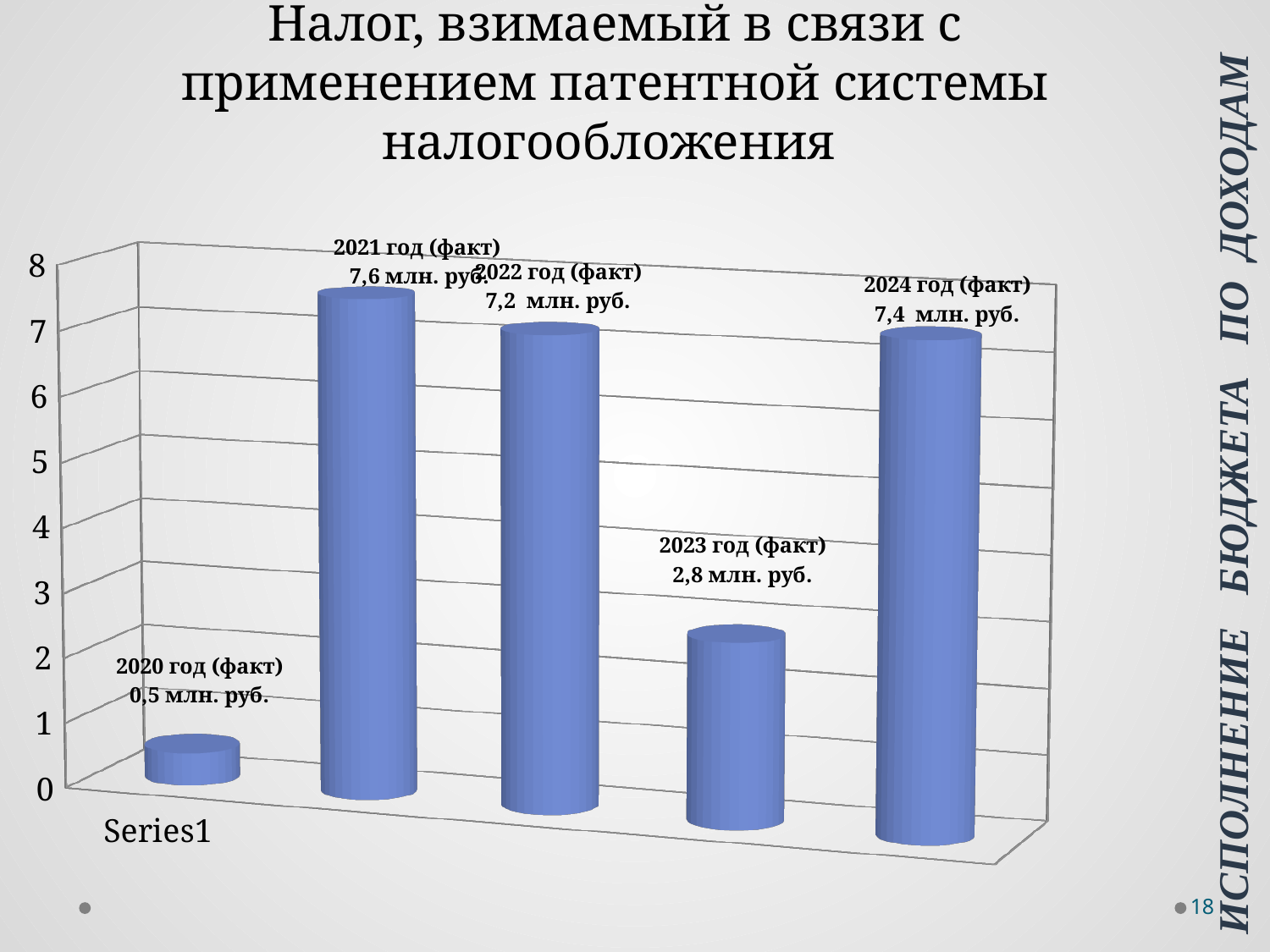
How many bars are plotted on the chart? 5 What kind of chart is shown on the slide? bar chart What is the value for 2024 год (факт)? 7,4 млн. руб. What is the difference between the values for 2021 год (факт) and 2023 год (факт)? 4,8 млн. руб. What is the value for 2020 год (факт)? 0,5 млн. руб. What is the value for 2023 год (факт)? 2,8 млн. руб. Which year has the lowest value? 2020 год (факт) Which year has the highest value? 2021 год (факт) Is the value for 2023 год (факт) greater or less than 4? less What is the value for 2021 год (факт)? 7,6 млн. руб. Which is larger, the value for 2022 год (факт) or 2024 год (факт)? 2024 год (факт) What is the title of the chart? Налог, взимаемый в связи с применением патентной системы налогообложения